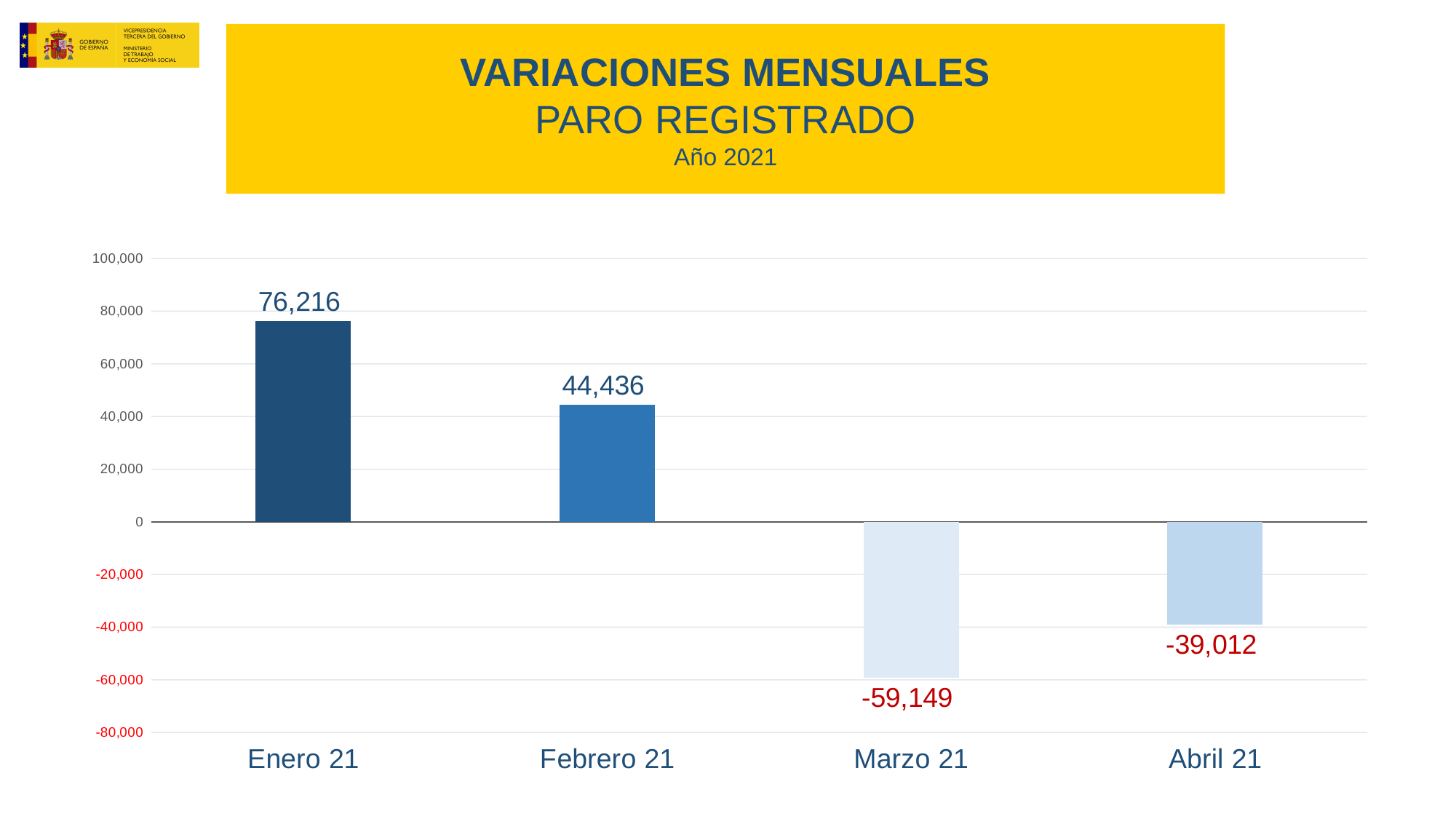
Which month has the highest value? Enero 21 What is the value for Abril 21? -39,012 What kind of chart is shown on the slide? Bar chart How many months are shown on the chart? 4 What is the value for Enero 21? 76,216 Which is larger, the value for Abril 21 or the value for Marzo 21? Abril 21 What is the difference between the values for Enero 21 and Febrero 21? 31,780 Do the values rise or fall from Enero 21 to Marzo 21? Fall Which month has the lowest value? Marzo 21 What year is given in the chart title? 2021 What is the value for Febrero 21? 44,436 What is the value for Marzo 21? -59,149